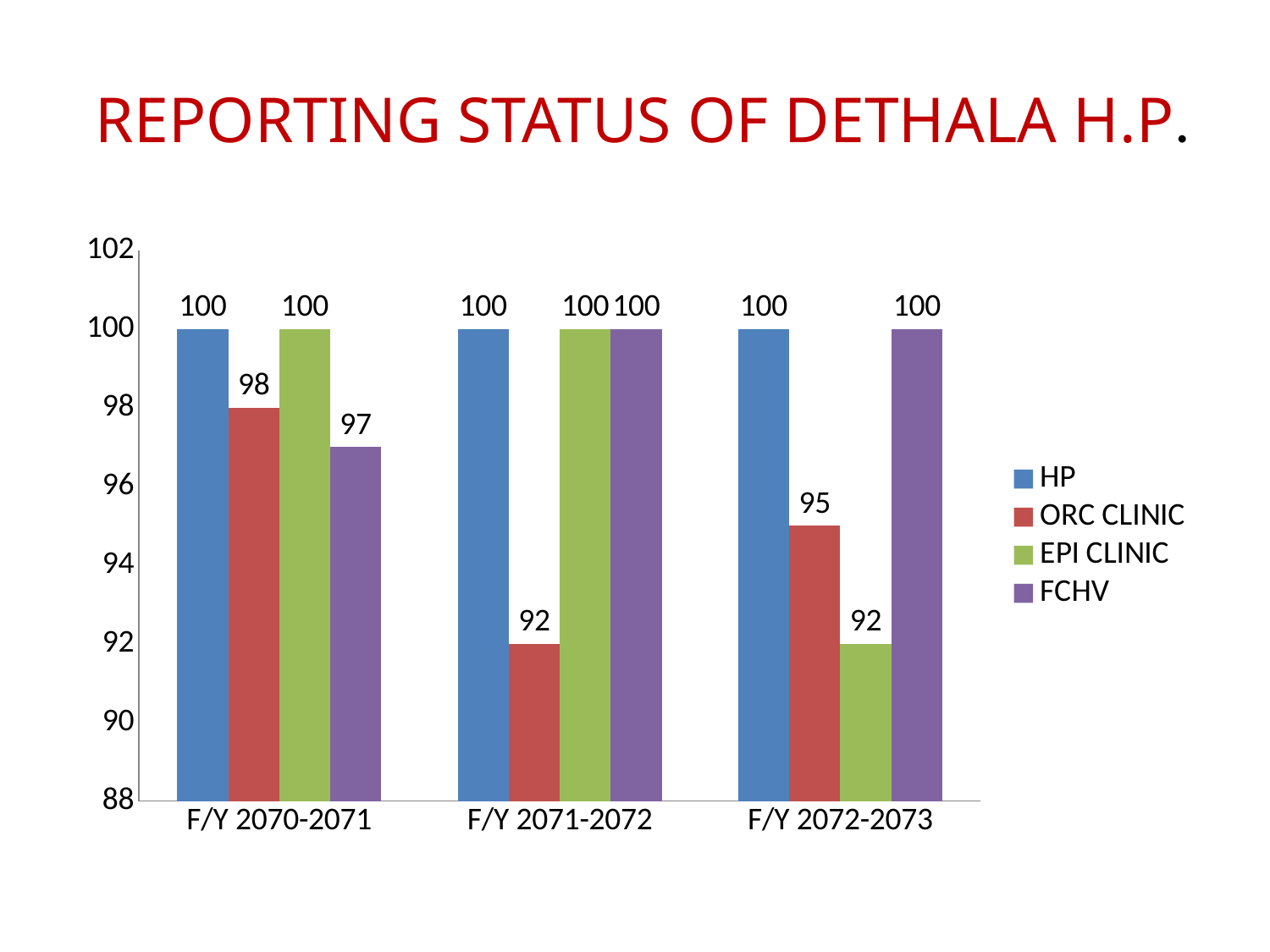
What is the title of the slide? REPORTING STATUS OF DETHALA H.P. What is the value for FCHV in F/Y 2070-2071? 97 How many series does the legend list? 4 What kind of chart is shown on the slide? Bar chart Which series has the lowest value in F/Y 2070-2071? FCHV What is the difference between the ORC CLINIC values in F/Y 2070-2071 and F/Y 2071-2072? 6 How many fiscal year categories are shown on the x axis? 3 What is the value for ORC CLINIC in F/Y 2071-2072? 92 Which is larger in F/Y 2072-2073, ORC CLINIC or EPI CLINIC? ORC CLINIC What is the value for ORC CLINIC in F/Y 2072-2073? 95 What is the value for EPI CLINIC in F/Y 2072-2073? 92 Which series has the lowest value in F/Y 2071-2072? ORC CLINIC